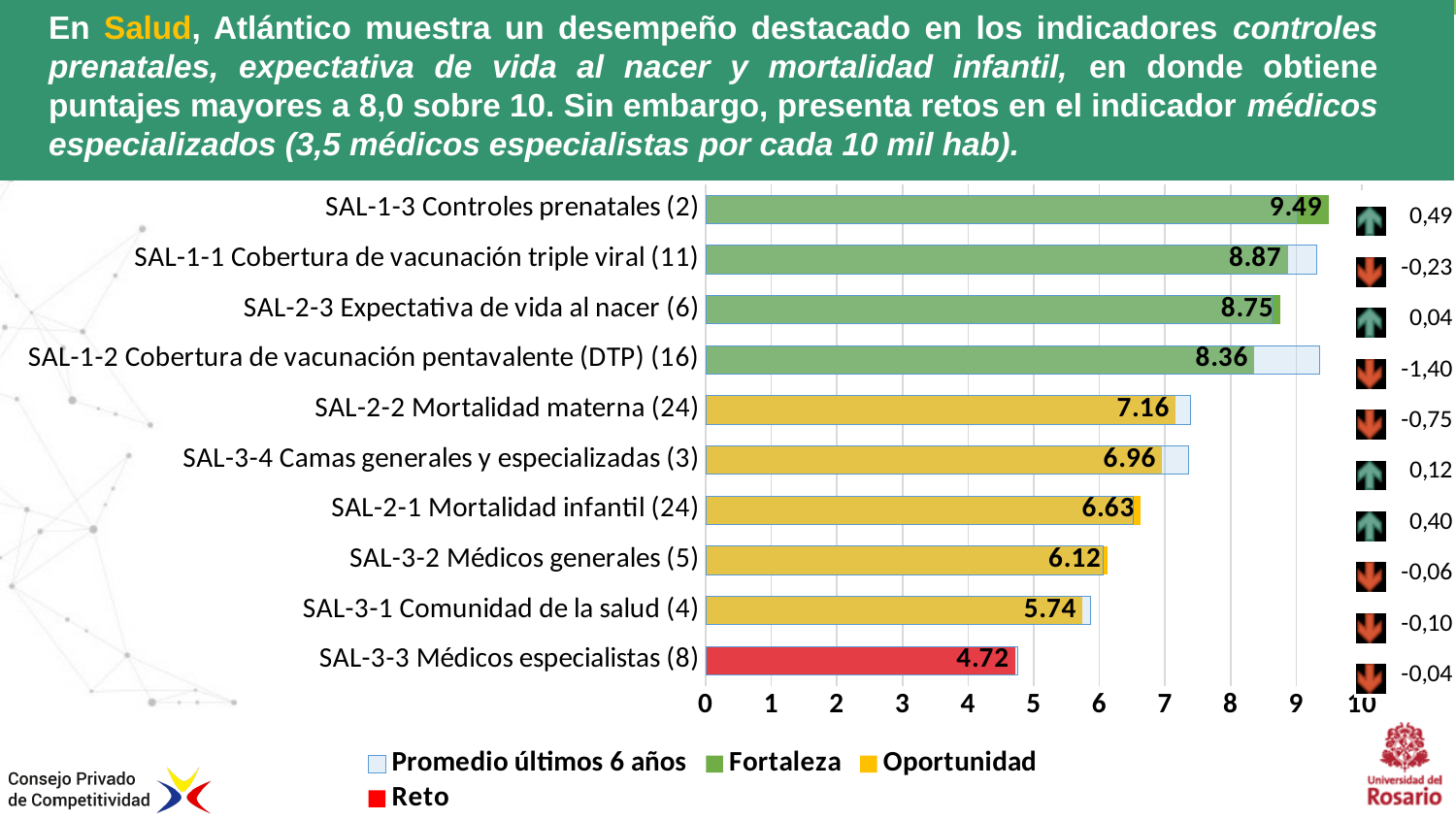
Which indicator has the highest value? SAL-1-3 Controles prenatales (2) What kind of chart is shown on the slide? bar chart How many entries does the legend list? 4 Which indicator has the lowest value? SAL-3-3 Médicos especialistas (8) Which legend category is shown in red? Reto What is the value for SAL-2-2 Mortalidad materna (24)? 7.16 What is the difference between the values for SAL-1-1 Cobertura de vacunación triple viral (11) and SAL-2-3 Expectativa de vida al nacer (6)? 0.12 Which is larger, the value for SAL-3-4 Camas generales y especializadas (3) or SAL-2-1 Mortalidad infantil (24)? SAL-3-4 Camas generales y especializadas (3) Is the value for SAL-3-1 Comunidad de la salud (4) greater or less than 6? less What is the value for SAL-3-3 Médicos especialistas (8)? 4.72 How many indicators are shown in the chart? 10 What is the value for SAL-1-3 Controles prenatales (2)? 9.49